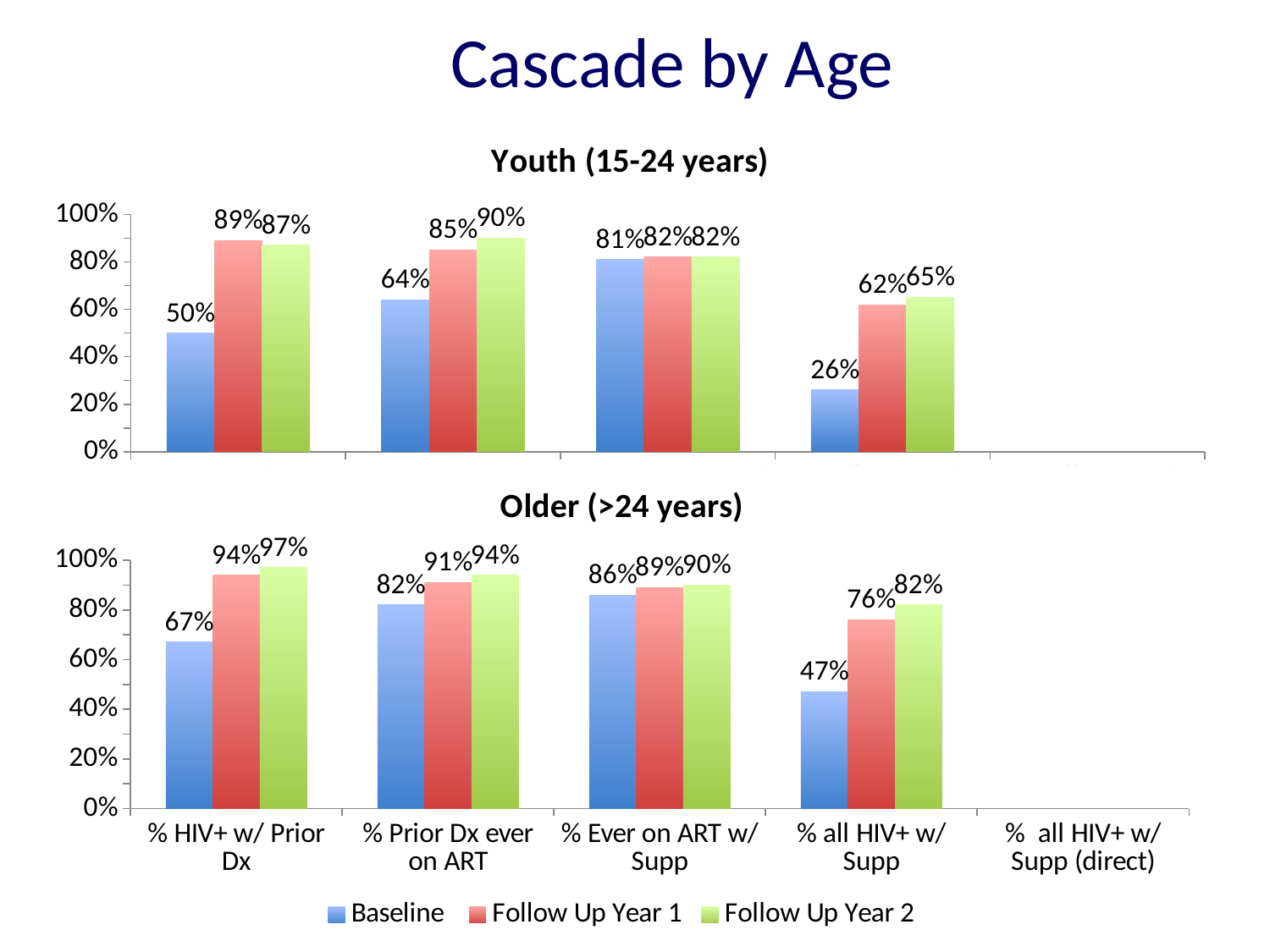
In the Older (>24 years) chart, do the values for % Ever on ART w/ Supp rise or fall from Baseline to Follow Up Year 2? rise In the Youth (15-24 years) chart, is the Baseline value for % HIV+ w/ Prior Dx larger or the Follow Up Year 1 value? Follow Up Year 1 In the Youth (15-24 years) chart, which category has the highest Follow Up Year 2 value? % Prior Dx ever on ART In the Older (>24 years) chart, what is the difference between the Follow Up Year 1 and Baseline values for % HIV+ w/ Prior Dx? 27% How many series does the legend list? 3 In the Youth (15-24 years) chart, what is the difference between the Follow Up Year 2 and Baseline values for % all HIV+ w/ Supp? 39% In the Older (>24 years) chart, what is the Follow Up Year 2 value for % all HIV+ w/ Supp? 82% What kind of chart is the Older (>24 years) chart? bar chart In the Older (>24 years) chart, which category has the lowest Baseline value? % all HIV+ w/ Supp In the Older (>24 years) chart, is the Baseline value for % all HIV+ w/ Supp greater or less than 60%? less In the Youth (15-24 years) chart, what is the Baseline value for % HIV+ w/ Prior Dx? 50% In the Youth (15-24 years) chart, what is the Follow Up Year 1 value for % Prior Dx ever on ART? 85%